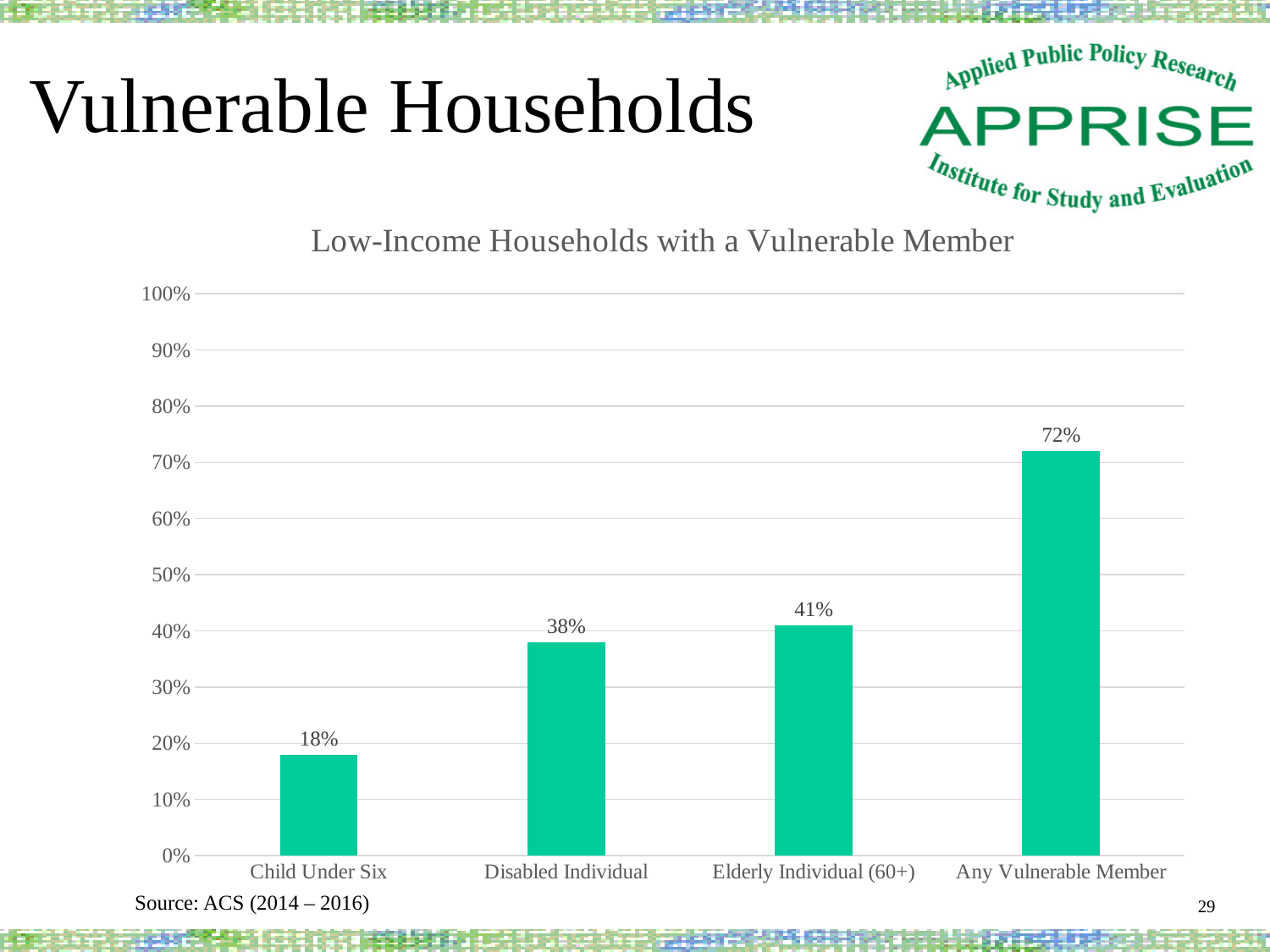
What kind of chart is shown on the slide? Bar chart What percentage of low-income households have an elderly individual (60+)? 41% What is the value for Any Vulnerable Member? 72% Which is larger, the value for Disabled Individual or the value for Child Under Six? Disabled Individual What is the title of the chart? Low-Income Households with a Vulnerable Member How many categories are shown on the x axis? 4 Which category has the lowest value? Child Under Six What is the difference between the values for Any Vulnerable Member and Child Under Six? 54% What is the difference between the values for Elderly Individual (60+) and Disabled Individual? 3% Which category has the highest value? Any Vulnerable Member What is the value shown for Disabled Individual? 38% What percentage of low-income households have a child under six? 18%